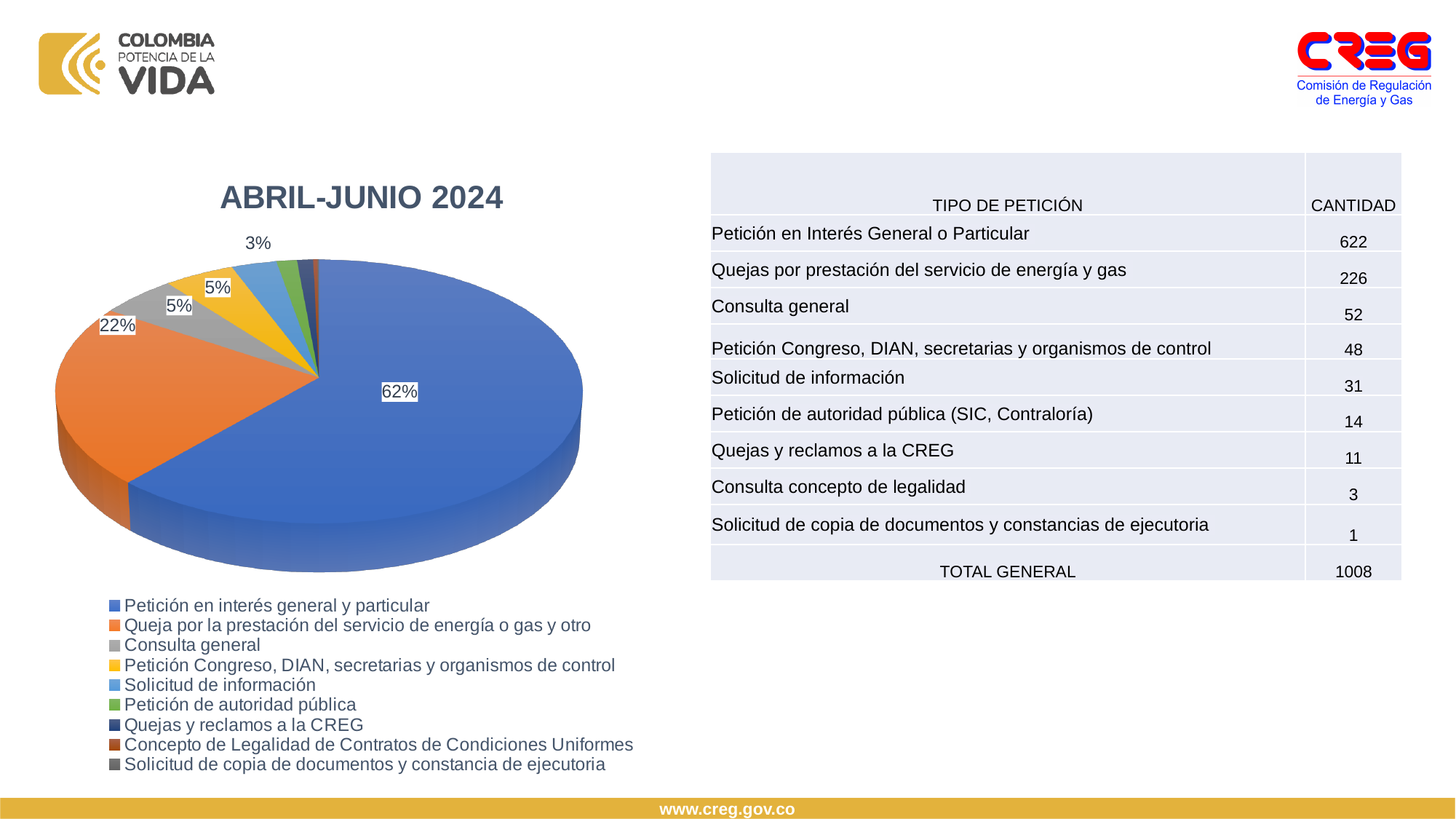
What share of the pie does 'Solicitud de información' represent? 3% Which slice is larger: 'Queja por la prestación del servicio de energía o gas y otro' or 'Consulta general'? Queja por la prestación del servicio de energía o gas y otro What share of the pie does 'Petición Congreso, DIAN, secretarias y organismos de control' represent? 5% What colour is the slice for 'Petición en interés general y particular'? blue What is the difference in percentage points between the 'Petición en interés general y particular' slice and the 'Queja por la prestación del servicio de energía o gas y otro' slice? 40 What is the title of the pie chart? ABRIL-JUNIO 2024 What kind of chart is shown on the slide? pie chart What share of the pie does 'Queja por la prestación del servicio de energía o gas y otro' represent? 22% How many entries does the legend of the pie chart list? 9 Which category has the largest slice of the pie? Petición en interés general y particular